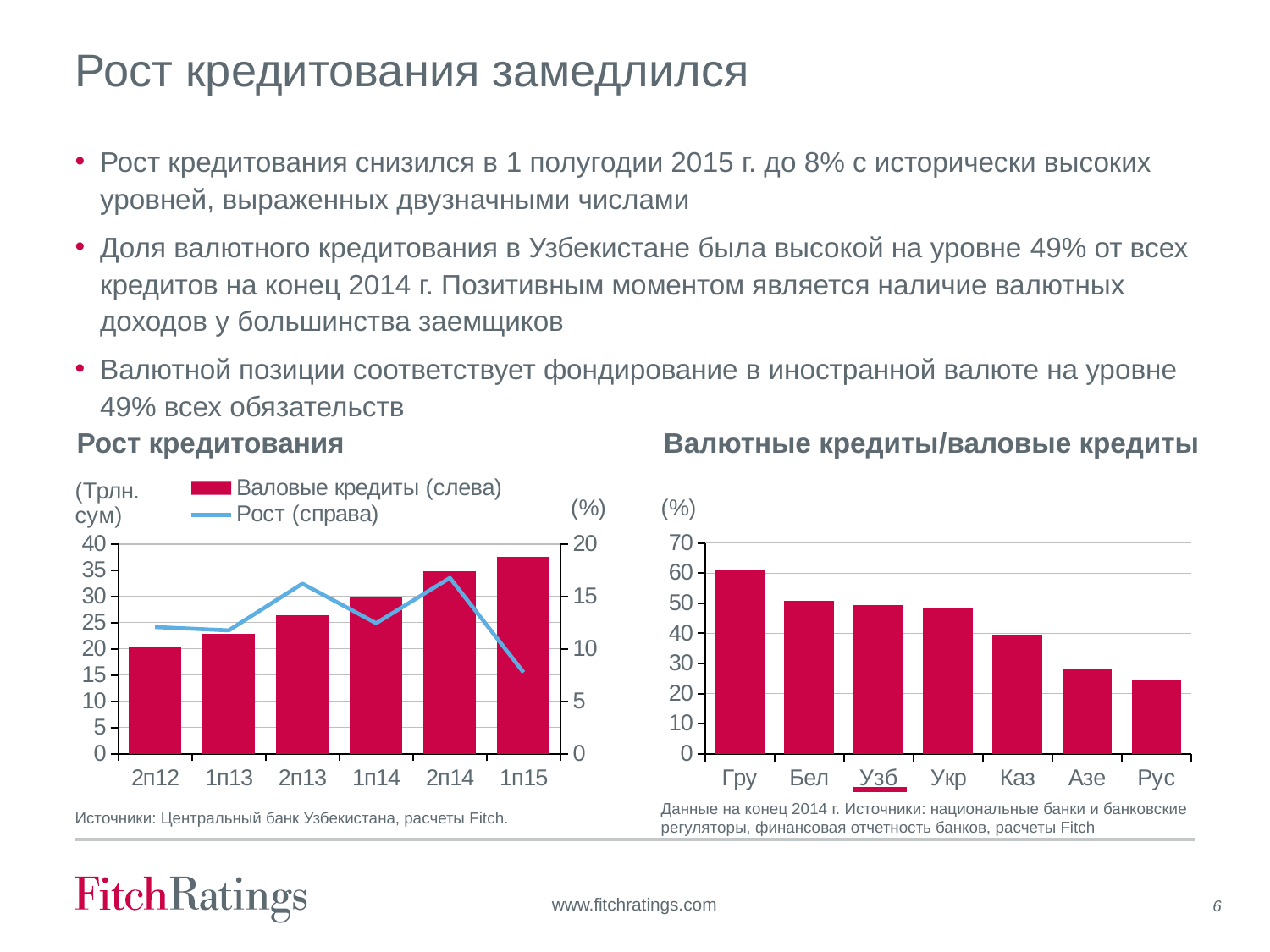
In the "Рост кредитования" chart, do the Валовые кредиты bars rise or fall from 2п12 to 1п15? rise In the "Рост кредитования" chart, which period has the highest bar for Валовые кредиты? 1п15 How many periods are shown on the x axis of the "Рост кредитования" chart? 6 How many series does the legend of the "Рост кредитования" chart list? 2 In the "Рост кредитования" chart, which period has the lowest bar for Валовые кредиты? 2п12 How many countries are shown in the "Валютные кредиты/валовые кредиты" chart? 7 In the "Рост кредитования" chart, is the Рост value for 1п15 greater or less than 10 on the right axis? less What kind of chart is the "Рост кредитования" chart on the left? bar chart with a line In the "Валютные кредиты/валовые кредиты" chart, which country has the lowest value? Рус In the "Валютные кредиты/валовые кредиты" chart, is the value for Гру greater or less than 50? greater In the "Рост кредитования" chart, is the Валовые кредиты value for 1п15 greater or less than 35? greater In the "Валютные кредиты/валовые кредиты" chart, which country has the highest value? Гру